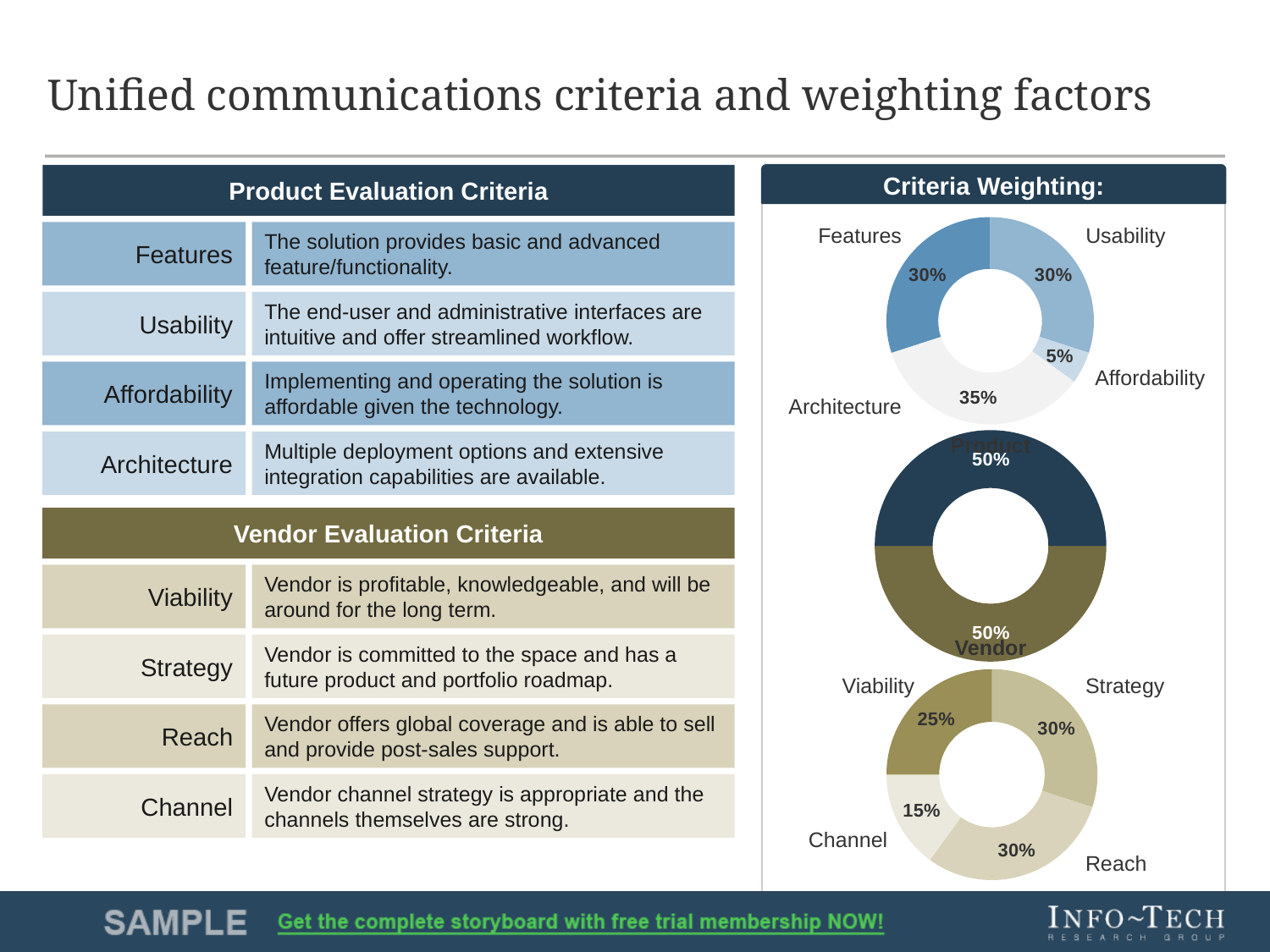
In the bottom donut chart under Criteria Weighting, what is the weighting for Viability? 25% In the top donut chart under Criteria Weighting, what is the difference between the weightings for Architecture and Affordability? 30% In the top donut chart under Criteria Weighting, what is the weighting for Architecture? 35% In the middle donut chart under Criteria Weighting, what is the weighting for Product? 50% In the bottom donut chart under Criteria Weighting, which criterion has the lowest weighting? Channel In the middle donut chart under Criteria Weighting, how many segments are shown? 2 In the top donut chart under Criteria Weighting, which criterion has the highest weighting? Architecture In the bottom donut chart under Criteria Weighting, which is larger, the weighting for Viability or for Strategy? Strategy In the top donut chart under Criteria Weighting, what is the weighting for Affordability? 5% In the bottom donut chart under Criteria Weighting, what is the weighting for Channel? 15% In the top donut chart under Criteria Weighting, which criterion has the lowest weighting? Affordability What type of chart is used to show the criteria weightings on the slide? Donut (pie) chart